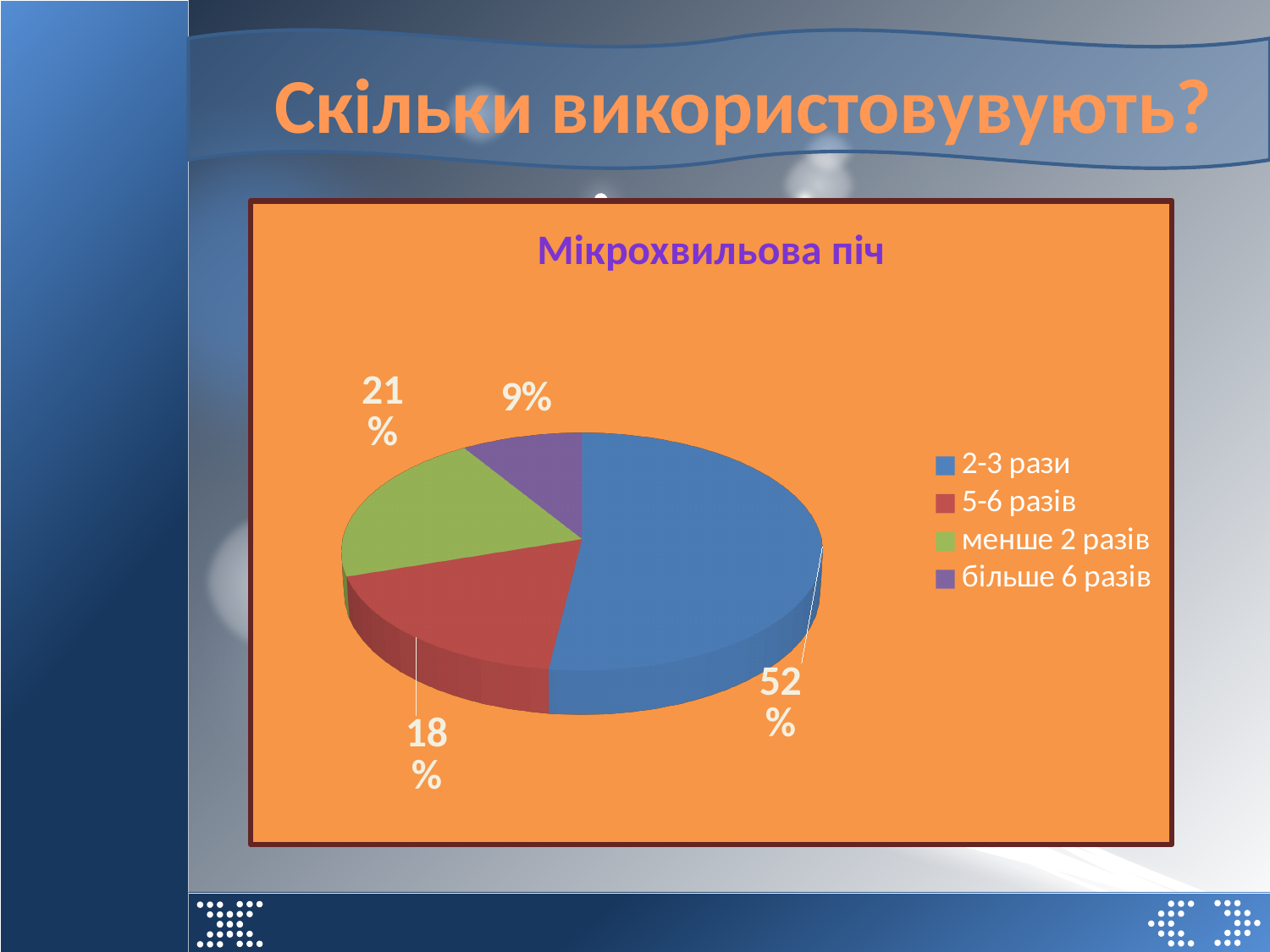
Which is larger, the 'менше 2 разів' slice or the '5-6 разів' slice? менше 2 разів What colour is the slice for '2-3 рази'? blue Which category has the largest slice of the pie? 2-3 рази How many categories does the legend list? 4 What is the title of the chart? Мікрохвильова піч What is the difference between the '2-3 рази' slice and the 'менше 2 разів' slice? 31% What percentage of the pie is labelled for 'менше 2 разів'? 21% What percentage of the pie is labelled for 'більше 6 разів'? 9% What type of chart is shown on the slide? pie chart Which category has the smallest slice of the pie? більше 6 разів What percentage of the pie is labelled for '2-3 рази'? 52% What percentage of the pie is labelled for '5-6 разів'? 18%